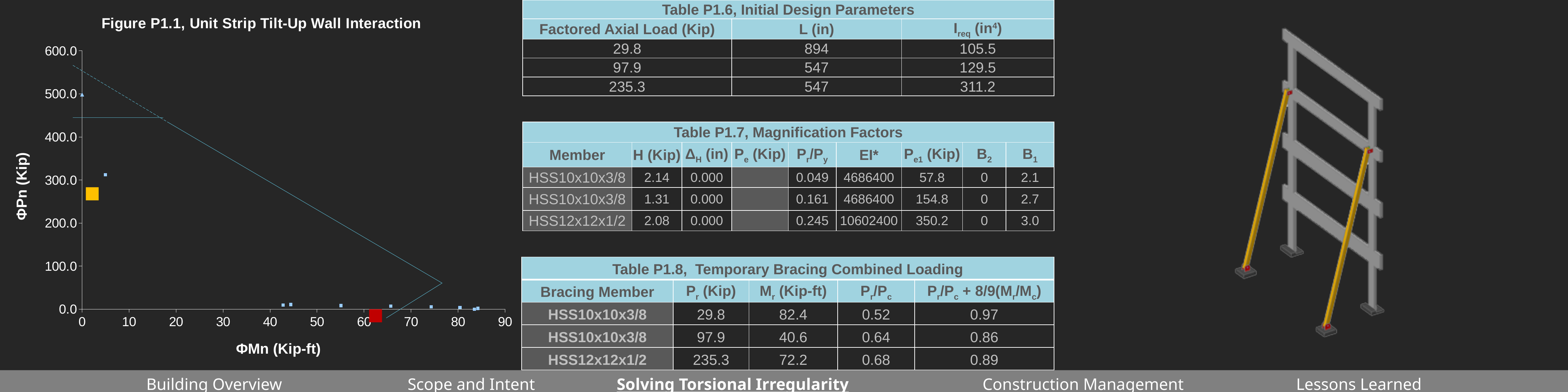
What kind of chart is Figure P1.1? scatter chart In Figure P1.1, is the ΦMn value of the red square marker greater or less than 70? less In Figure P1.1, is the ΦPn value of the horizontal line segment near the top left greater or less than 500? less In Figure P1.1, is the ΦPn value where the dashed line meets the vertical axis greater or less than 500? greater In Figure P1.1, which marker has the larger ΦPn value, the yellow square or the red square? the yellow square What is the title of the chart on the slide? Figure P1.1, Unit Strip Tilt-Up Wall Interaction What is the label on the vertical axis of the chart? ΦPn (Kip)